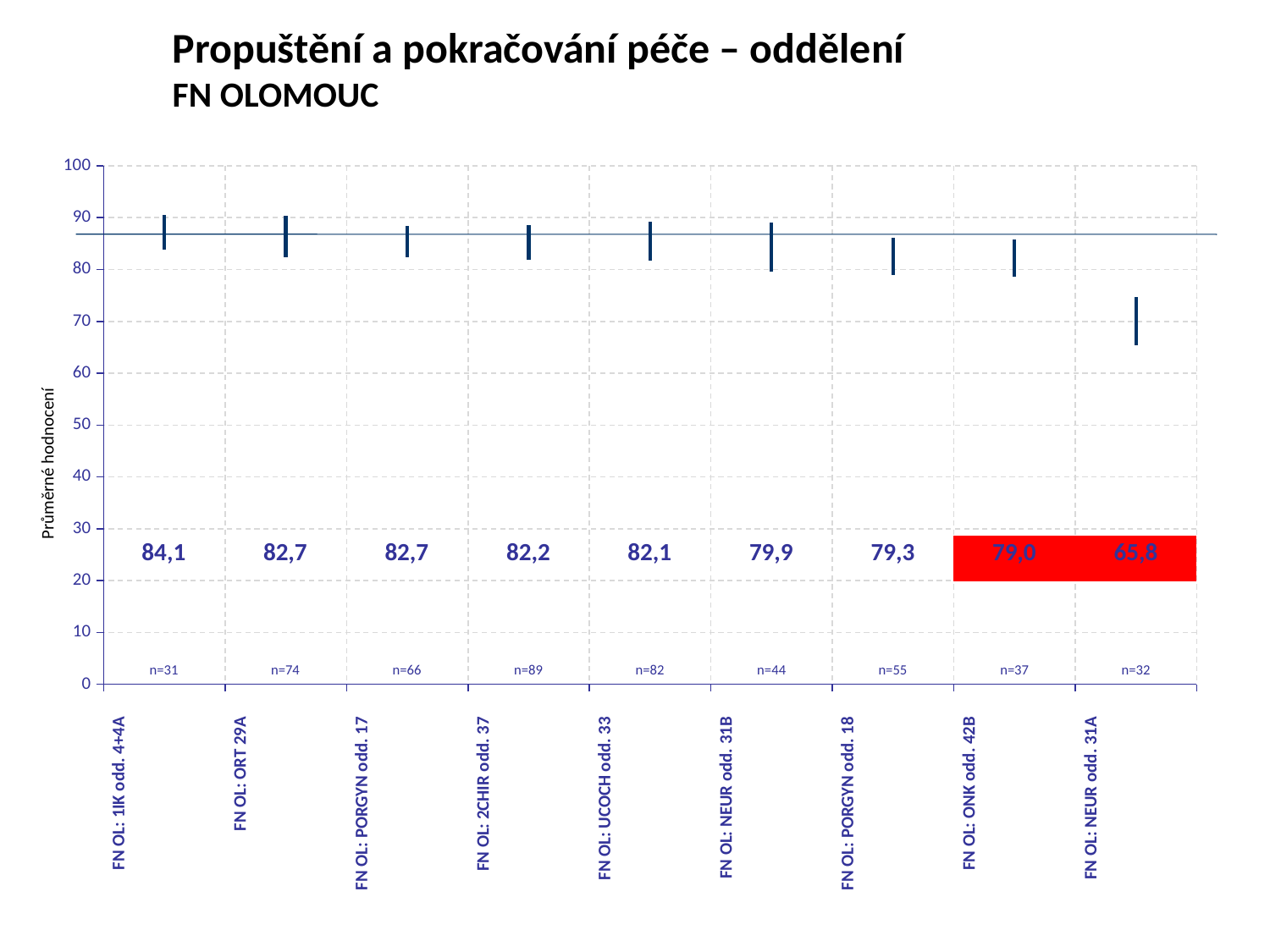
What is the difference between the average rating of FN OL: 1IK odd. 4+4A and FN OL: NEUR odd. 31A? 18,3 What is the sample size (n) for FN OL: 2CHIR odd. 37? n=89 Which has a higher average rating, FN OL: UCOCH odd. 33 or FN OL: NEUR odd. 31B? FN OL: UCOCH odd. 33 What is the average rating for FN OL: ONK odd. 42B? 79,0 What is the title of the chart? Propuštění a pokračování péče – oddělení FN OLOMOUC What is the sample size (n) for FN OL: ORT 29A? n=74 Which department has the highest average rating? FN OL: 1IK odd. 4+4A Which department has the lowest average rating? FN OL: NEUR odd. 31A Do the average ratings rise or fall from left to right along the x axis? fall What is the average rating (průměrné hodnocení) for FN OL: 1IK odd. 4+4A? 84,1 How many departments are shown on the chart? 9 What is the average rating for FN OL: NEUR odd. 31A? 65,8